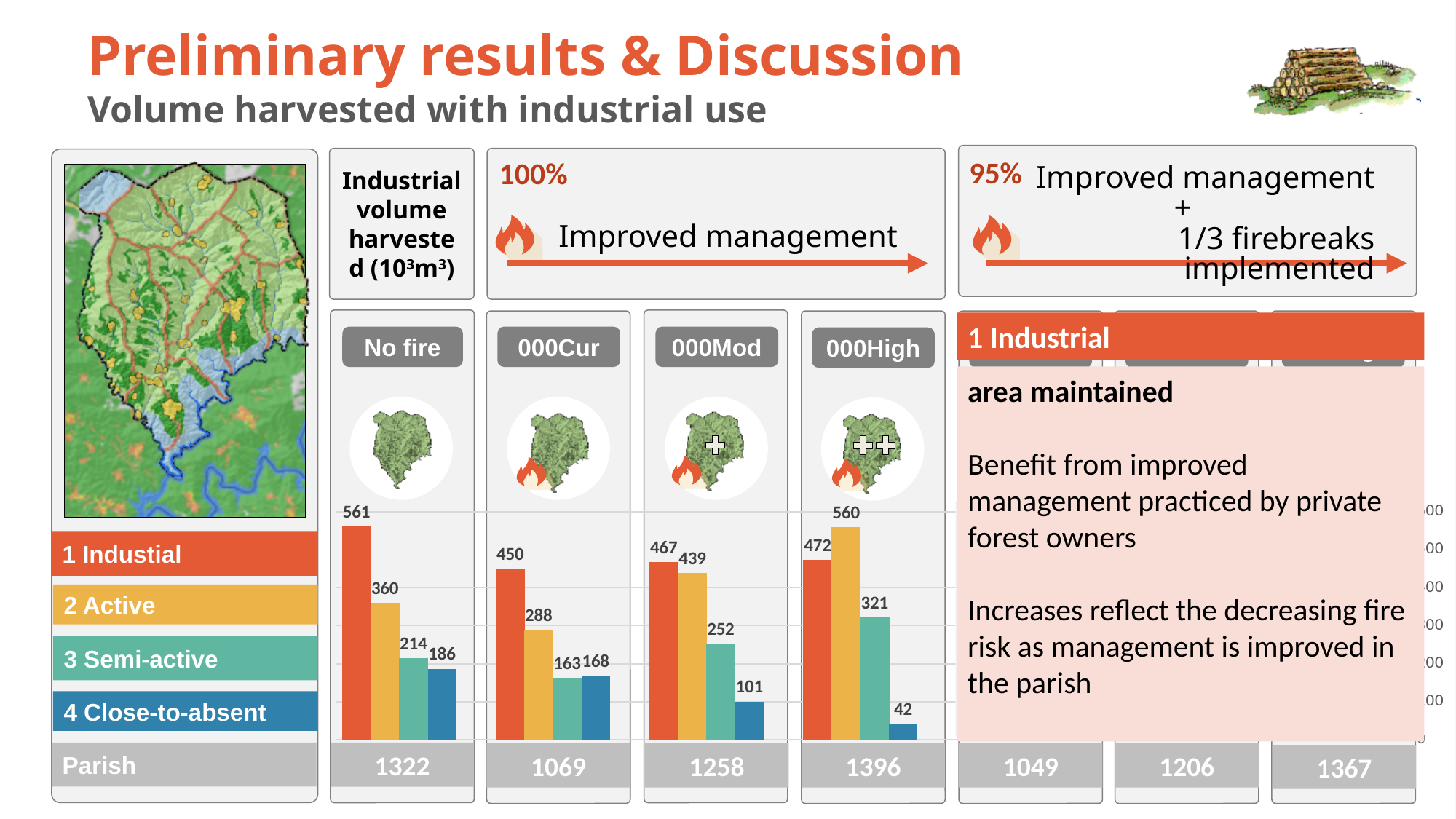
Which colour represents the Close-to-absent category in the charts? Blue In the "000Mod" chart, what is the value for the Semi-active category? 252 In the "000Cur" chart, which category has the lowest value? Semi-active In the "000Mod" chart, which is larger, the Industrial value or the Active value? Industrial How many bars are shown in the "000High" chart? 4 In the "000High" chart, what is the value for the Close-to-absent category? 42 What is the Parish total shown below the "000High" chart? 1396 In the "No fire" chart, what is the value for the Industrial category? 561 In the "000High" chart, which category has the highest value? Active What type of chart is the "No fire" chart? Bar chart In the "No fire" chart, what is the difference between the Industrial and Active values? 201 In the "000Cur" chart, what is the value for the Active category? 288